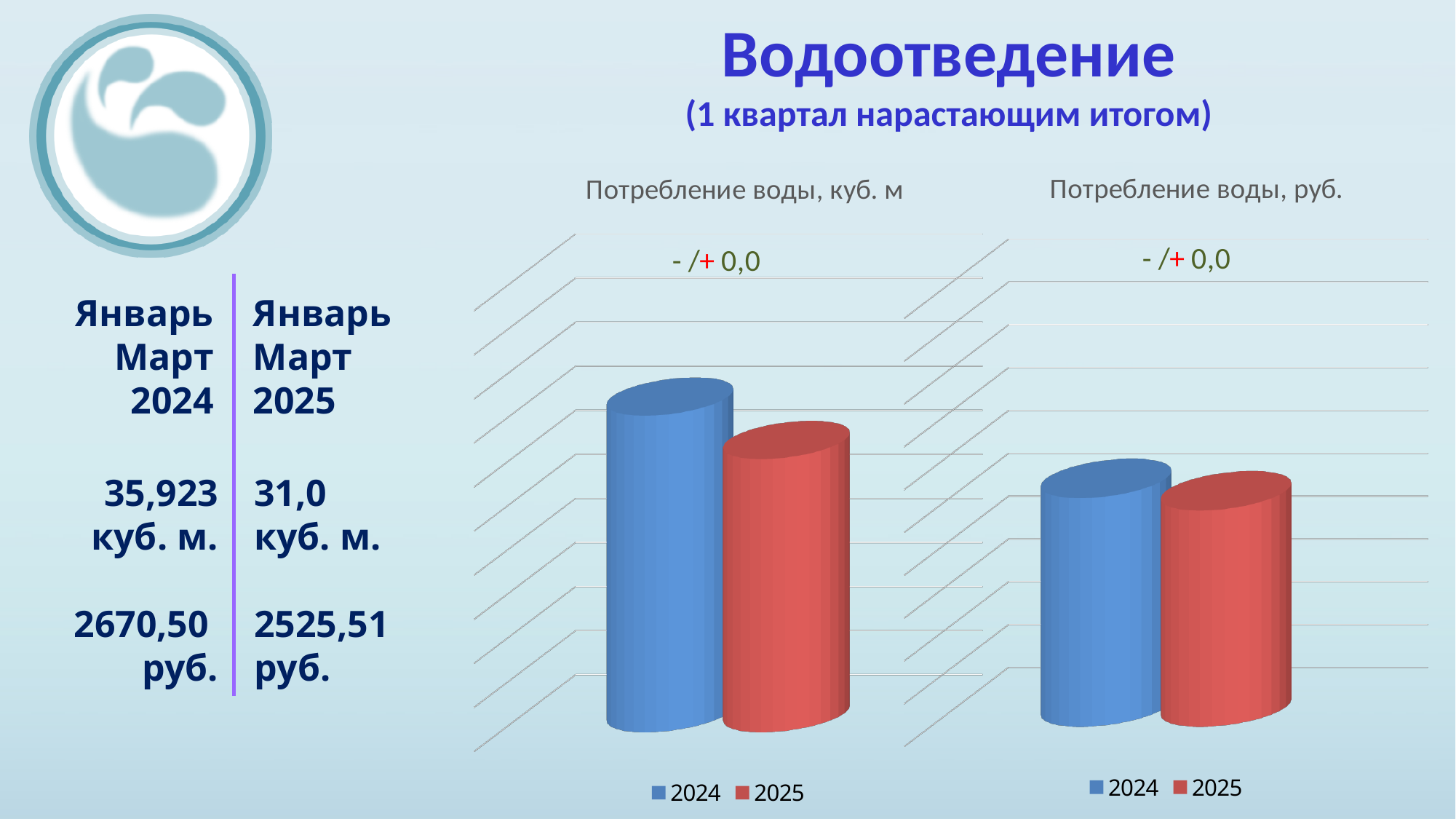
In the chart titled "Потребление воды, куб. м", which series has the highest value? 2024 How many series does the legend of the chart titled "Потребление воды, руб." list? 2 In the chart titled "Потребление воды, куб. м", which series has the taller bar, 2024 or 2025? 2024 What colour represents the 2025 series in the charts on the slide? red What is the title of the right-hand chart on the slide? Потребление воды, руб. In the chart titled "Потребление воды, куб. м", do the values rise or fall from 2024 to 2025? fall What kind of chart is the chart titled "Потребление воды, куб. м"? bar chart In the chart titled "Потребление воды, руб.", which series has the lowest value? 2025 In the chart titled "Потребление воды, руб.", do the values rise or fall from 2024 to 2025? fall How many bars are plotted in the chart titled "Потребление воды, куб. м"? 2 What are the two series listed in the legend of the chart titled "Потребление воды, куб. м"? 2024 and 2025 In the chart titled "Потребление воды, руб.", which series has the taller bar, 2024 or 2025? 2024